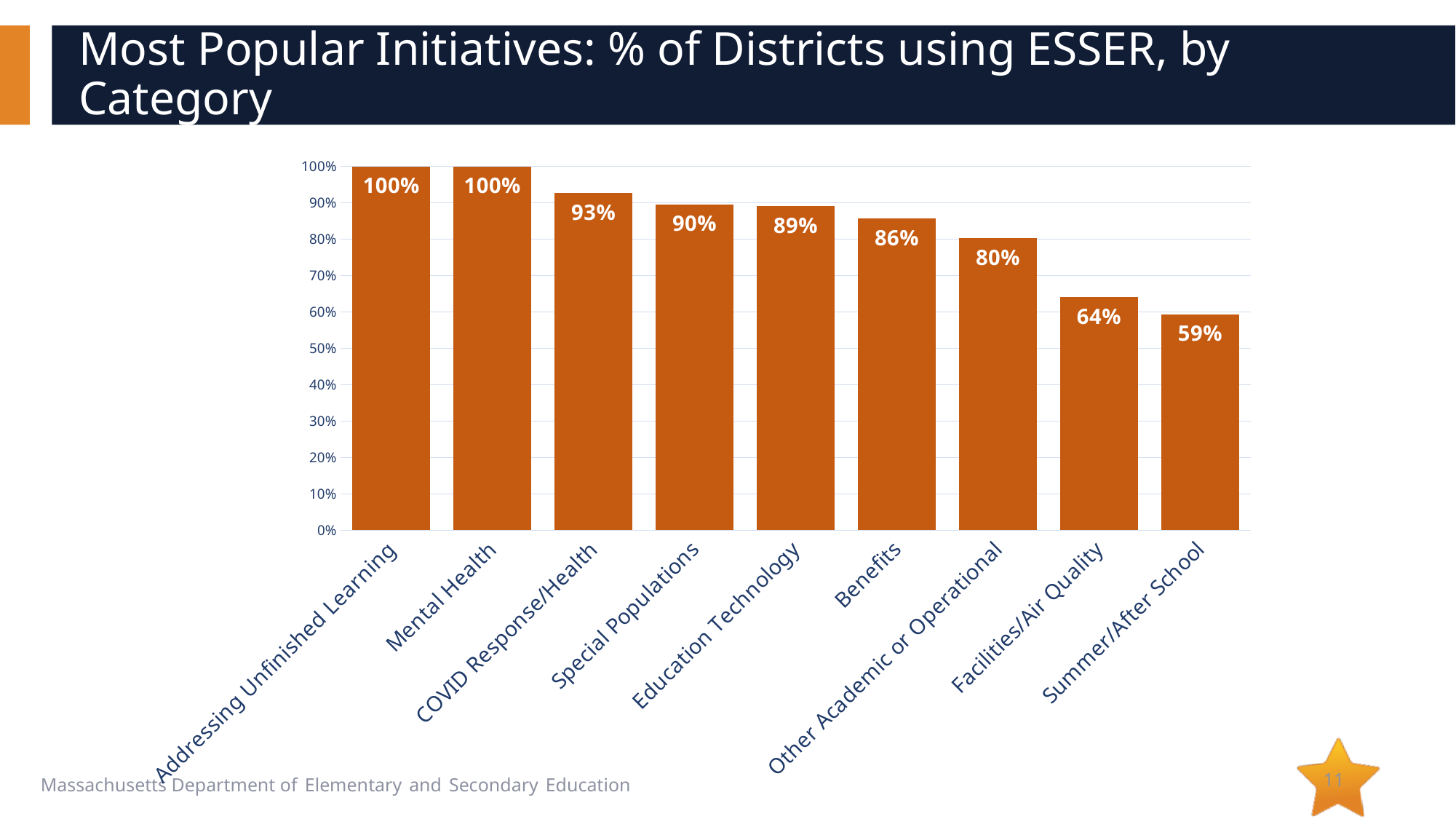
What is the value shown for Facilities/Air Quality? 64% Which is larger, the value for Benefits or the value for Facilities/Air Quality? Benefits What percentage of districts used ESSER for Special Populations? 90% Which category has the lowest percentage of districts using ESSER? Summer/After School What kind of chart is shown on the slide? Bar chart What is the difference between the values for Benefits and Other Academic or Operational? 6% Is the value for Other Academic or Operational greater or less than 70%? greater What is the difference between the values for COVID Response/Health and Summer/After School? 34% Do the values rise or fall moving from left to right across the categories? Fall What percentage of districts used ESSER for Education Technology? 89% How many categories are shown in the chart? 9 Which categories share the highest value of 100%? Addressing Unfinished Learning and Mental Health